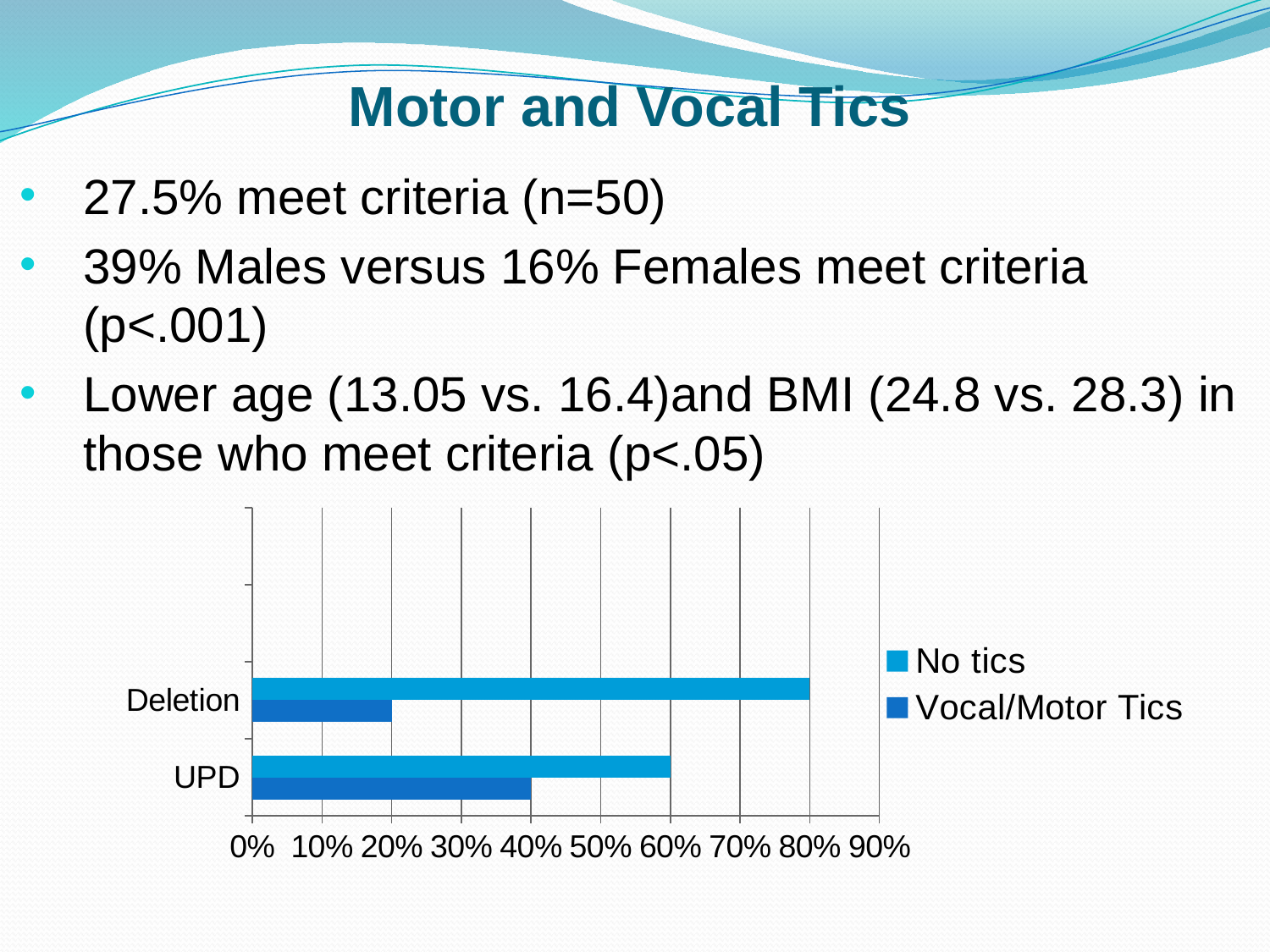
What are the two series names listed in the chart legend? No tics and Vocal/Motor Tics What is the No tics value for Deletion? 80% What kind of chart is shown on the slide? bar chart What is the difference between the No tics values for Deletion and UPD? 20% Is the No tics value for UPD greater or less than 50%? greater How many series does the chart legend list? 2 How many categories are shown on the chart's vertical axis? 2 What is the No tics value for UPD? 60% Which category has the highest No tics value? Deletion What is the Vocal/Motor Tics value for Deletion? 20% What is the Vocal/Motor Tics value for UPD? 40% Which category has the higher Vocal/Motor Tics value, Deletion or UPD? UPD